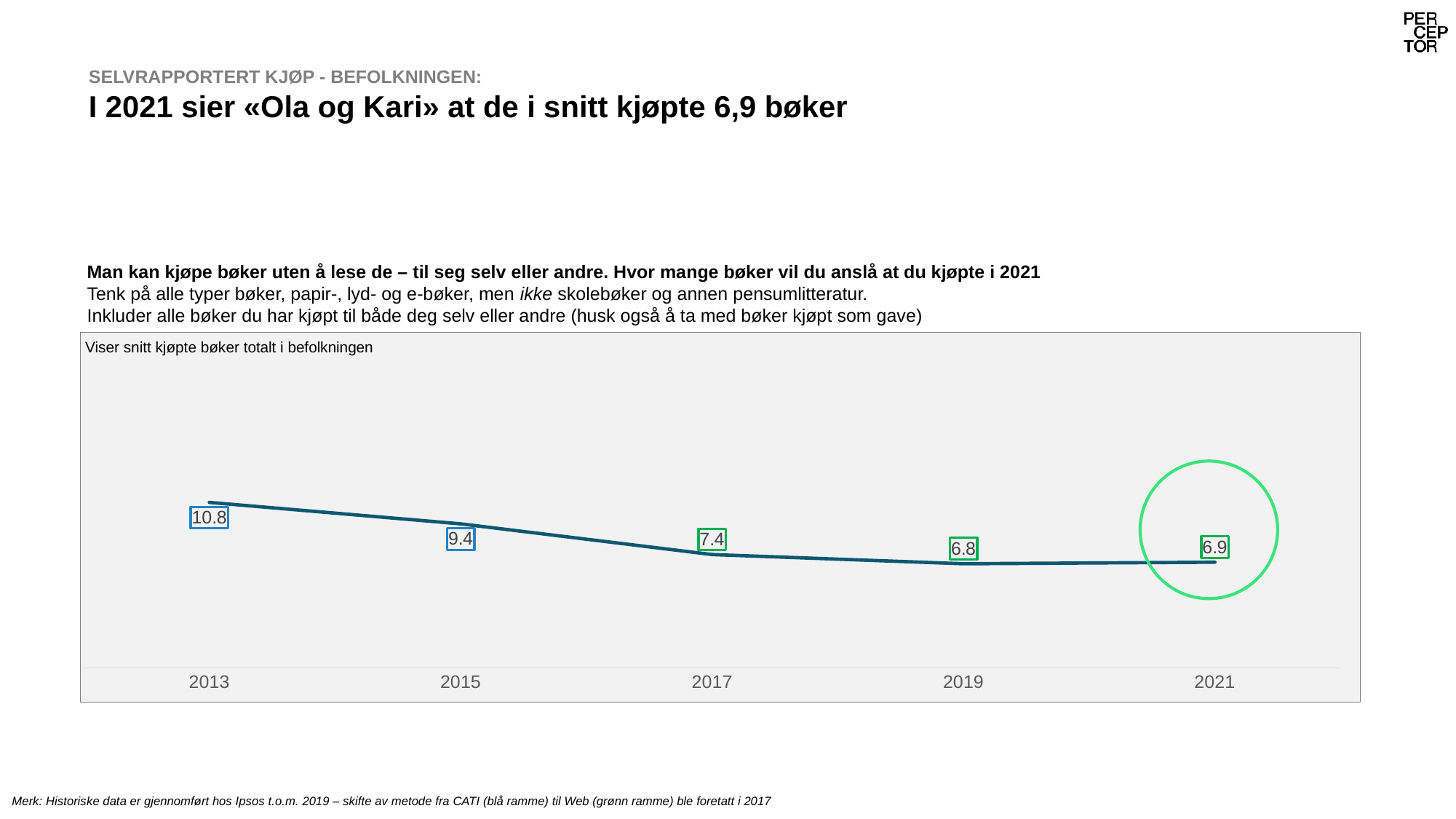
What is the value for 2015? 9.4 What is the difference between the values for 2013 and 2021? 3.9 What is the value for 2013? 10.8 What is the value for 2021? 6.9 What kind of chart is shown? Line chart Which year has the lowest value? 2019 What is the value for 2019? 6.8 Which year has the highest value? 2013 Which is larger, the value for 2015 or the value for 2017? 2015 What is the value for 2017? 7.4 Do the values generally rise or fall from 2013 to 2019? Fall How many years are plotted on the chart? 5